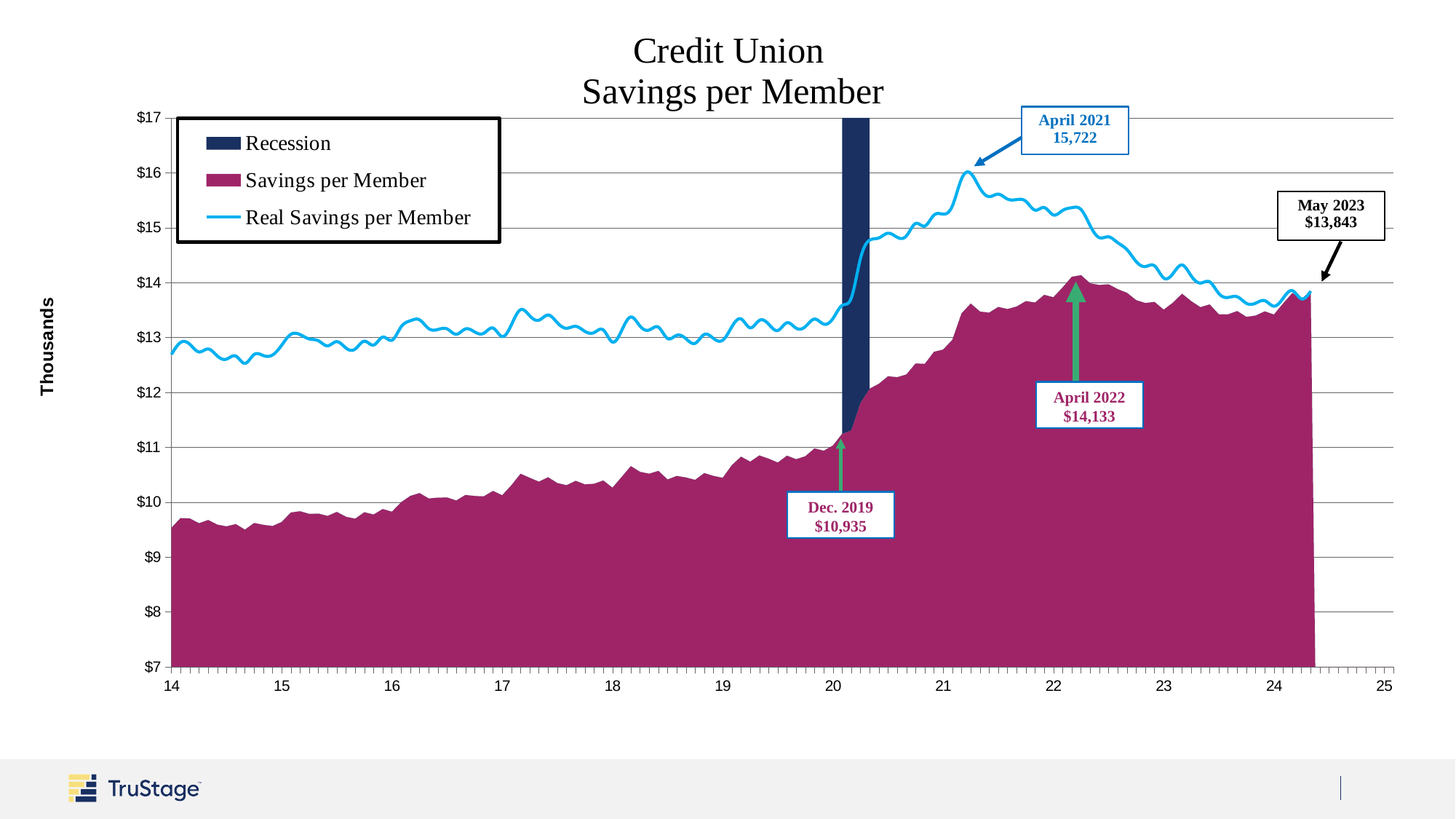
What value is labelled for Savings per Member in April 2022? $14,133 What is the label on the vertical axis? Thousands What value is labelled for Real Savings per Member in April 2021? 15,722 What is the title of the chart? Credit Union Savings per Member Is the Savings per Member value at the start of 2014 greater or less than $10? less Which is larger: the labelled April 2021 Real Savings per Member value or the labelled April 2022 Savings per Member value? April 2021 Real Savings per Member What value is labelled for Savings per Member in Dec. 2019? $10,935 Does Savings per Member generally rise or fall from 2014 to 2022? rise What is the difference between the labelled Savings per Member values for April 2022 and Dec. 2019? $3,198 What is the difference between the labelled April 2021 value (15,722) and the labelled May 2023 value ($13,843)? 1,879 How many series does the legend list? 3 What value is labelled for May 2023? $13,843